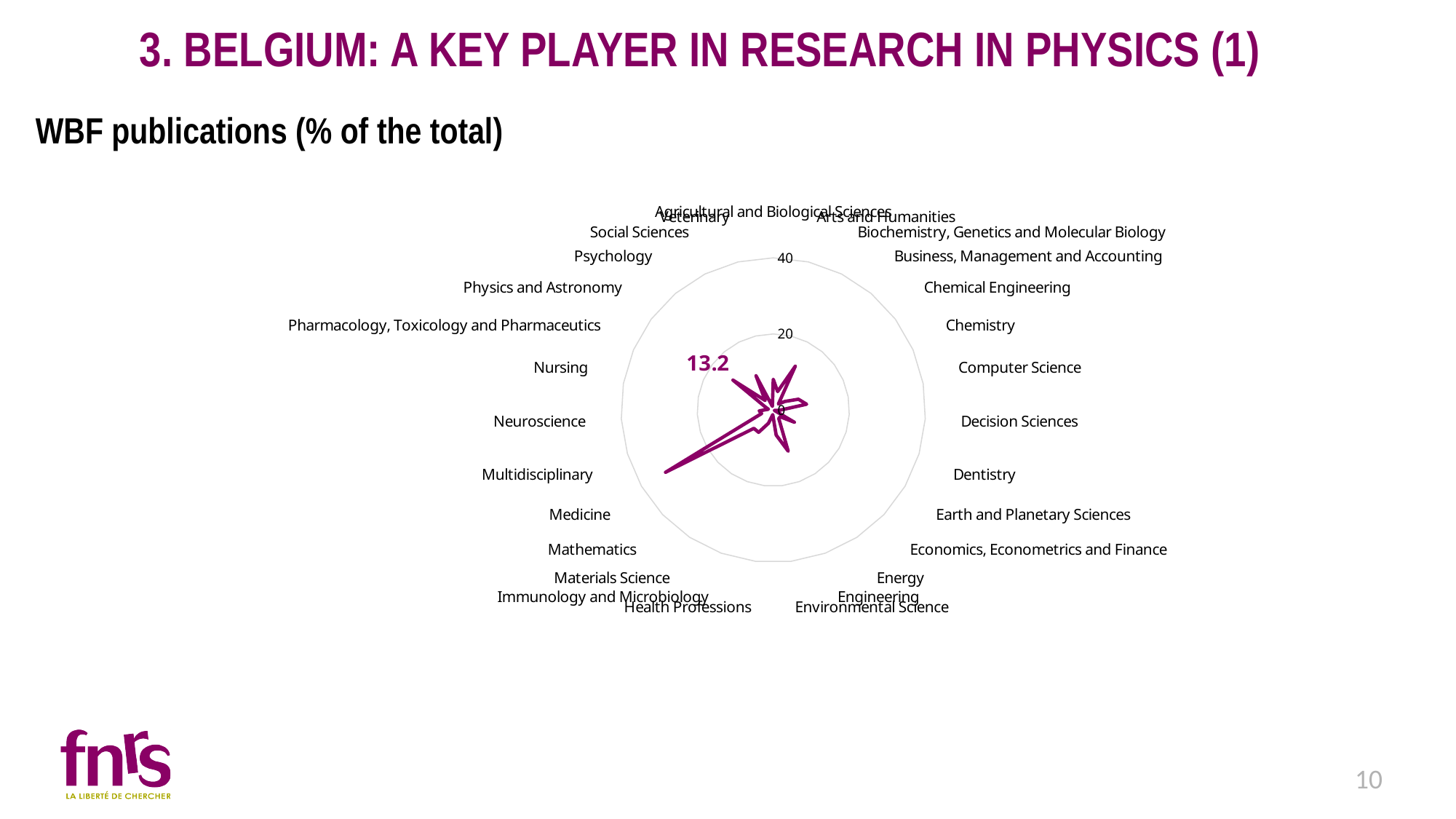
Is the value for Medicine greater or less than 40? less How many categories are plotted around the chart? 27 What is the value for Physics and Astronomy? 13.2 Is the value for Physics and Astronomy greater or less than 20? less What value is printed as a data label on the chart? 13.2 Which category has the highest value on the chart? Medicine Which is larger, the value for Medicine or the value for Physics and Astronomy? Medicine Is the value for Medicine greater or less than 20? greater What is the highest value shown on the chart's axis? 40 What kind of chart is shown on the slide? Radar chart